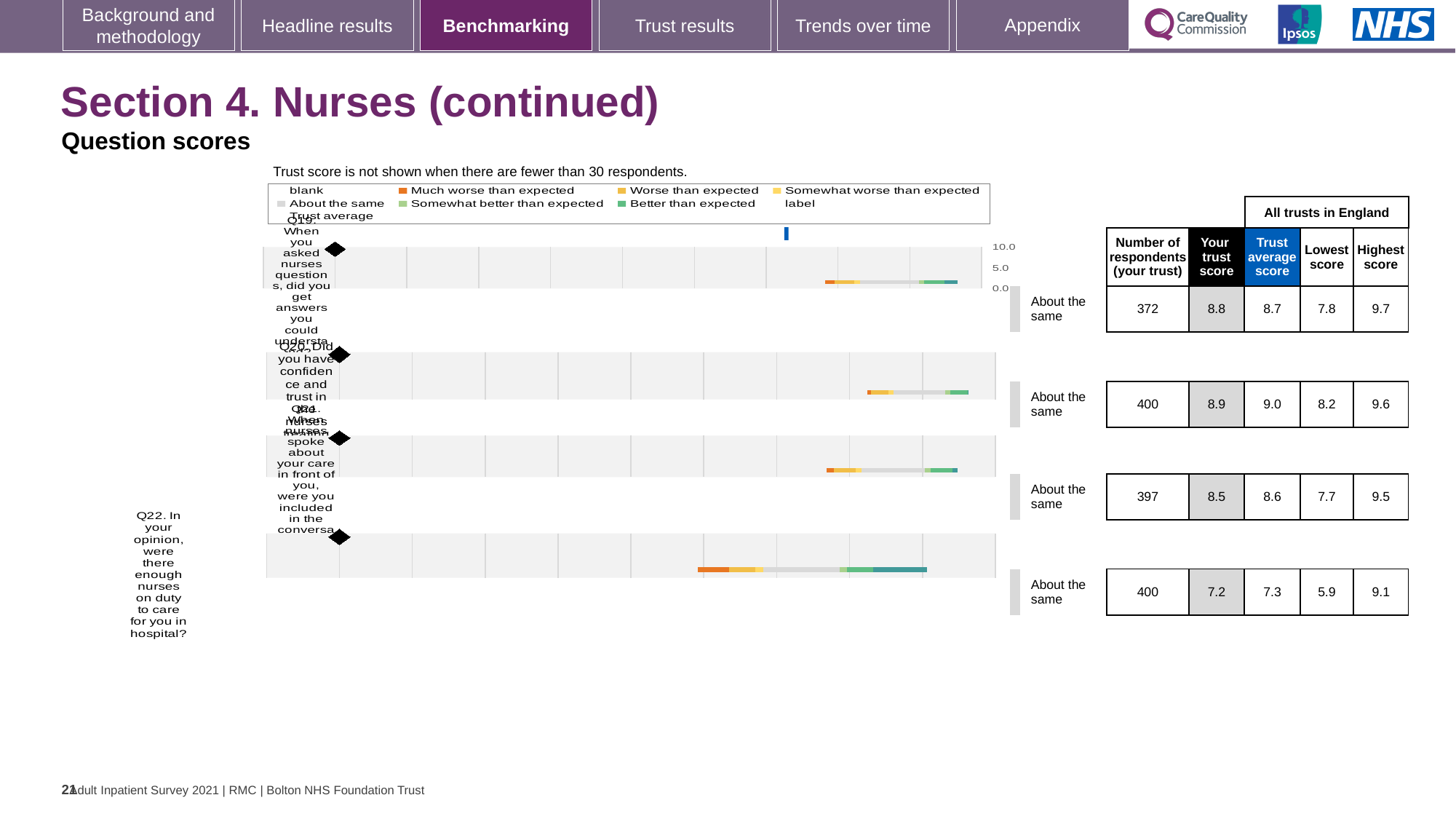
How many questions (categories) are plotted in the chart? 4 According to the table next to the chart, what is the trust score for Q22 (enough nurses on duty)? 7.2 Which legend entry is shown in orange on the chart? Much worse than expected What kind of chart is shown on the slide? bar chart According to the table next to the chart, what is the lowest score across all trusts in England for Q22? 5.9 What is the difference between the highest score and the lowest score for Q21 in the table next to the chart? 1.8 Which question has the lowest 'Your trust score' in the table next to the chart? Q22 According to the table next to the chart, what is the trust average score for Q20 (confidence and trust in nurses)? 9.0 Which question has the highest 'Your trust score' in the table next to the chart? Q20 Is the trust score for Q19 larger or smaller than the trust average score for Q19? larger According to the table next to the chart, how many respondents answered Q19? 372 What benchmark category is shown for all four questions on the chart? About the same